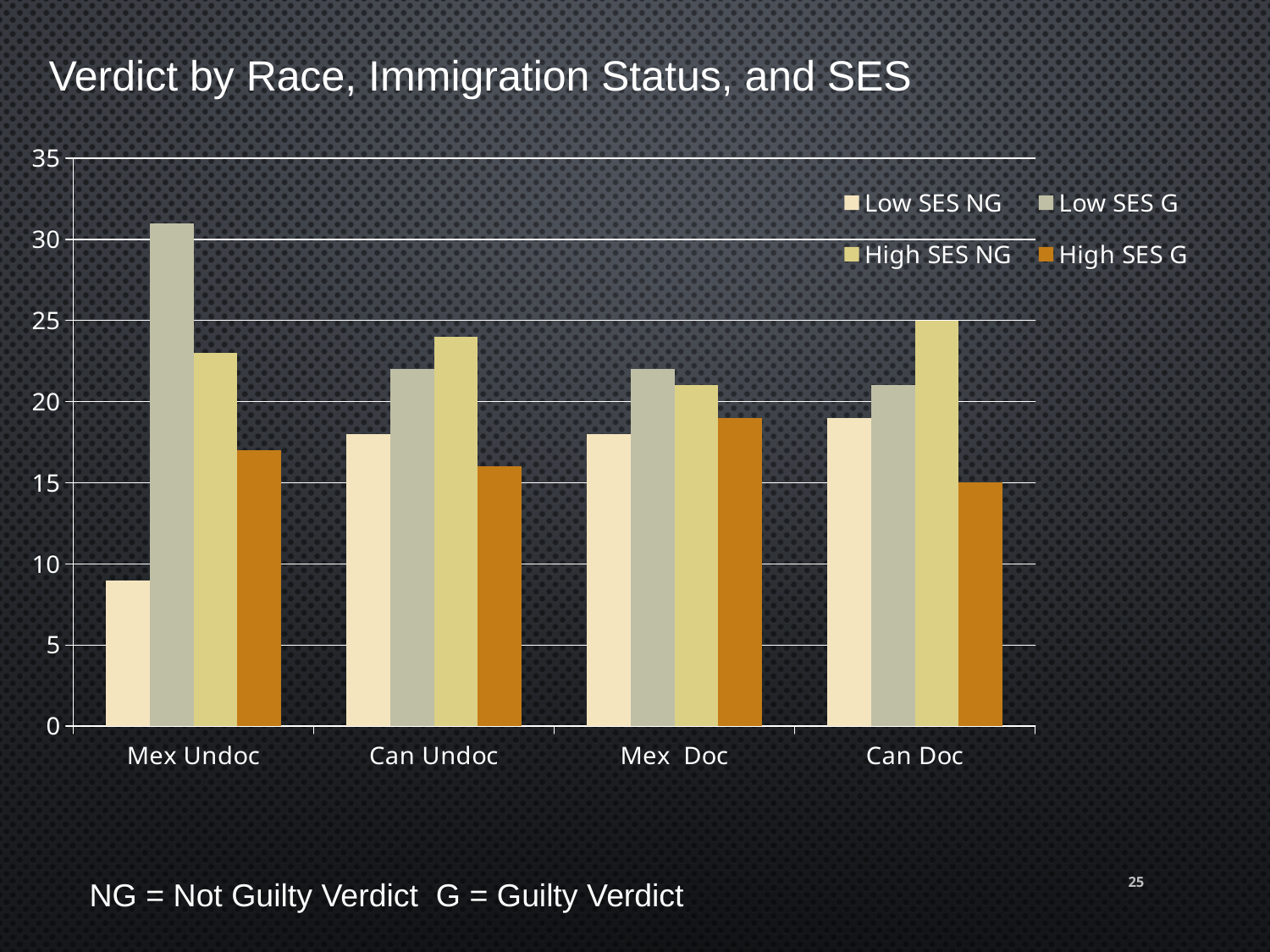
How many categories are shown on the x axis? 4 Which category has the lowest Low SES NG bar? Mex Undoc Is the High SES NG value for Mex Undoc greater or less than 20? greater Is the Low SES G value for Mex Undoc greater or less than 30? greater What kind of chart is shown on the slide? Bar chart What is the title of the chart? Verdict by Race, Immigration Status, and SES For Mex Undoc, which is larger: Low SES G or High SES G? Low SES G Is the Low SES NG value for Mex Undoc greater or less than 10? less For Can Doc, which is larger: High SES NG or High SES G? High SES NG Which category has the highest Low SES G bar? Mex Undoc How many series does the legend list? 4